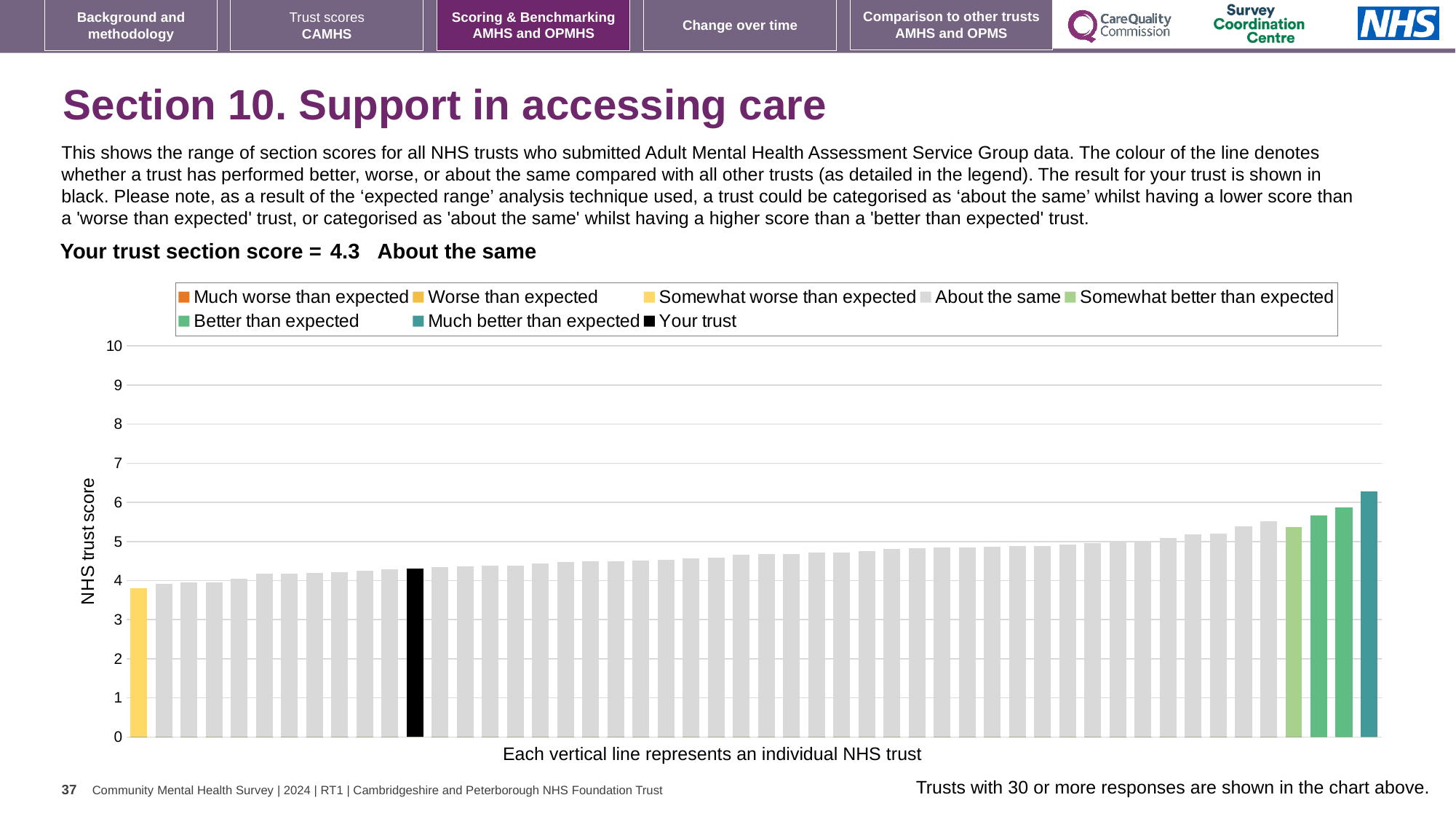
Do the bar values rise or fall from left to right along the x axis? rise Is the yellow bar higher or lower than the black bar? lower Is the value of the tallest bar greater or less than 6? greater Is the value of the shortest bar (the yellow bar) greater or less than 4? less Is the value for your trust (the black bar) greater or less than 5? less How many black bars are there in the chart? 1 Which legend category does the shortest bar belong to? Somewhat worse than expected What is the section score for your trust? 4.3 What kind of chart is shown on the slide? bar chart How many entries does the chart legend list? 8 What is the label on the y axis of the chart? NHS trust score Which legend category does the tallest bar belong to? Much better than expected